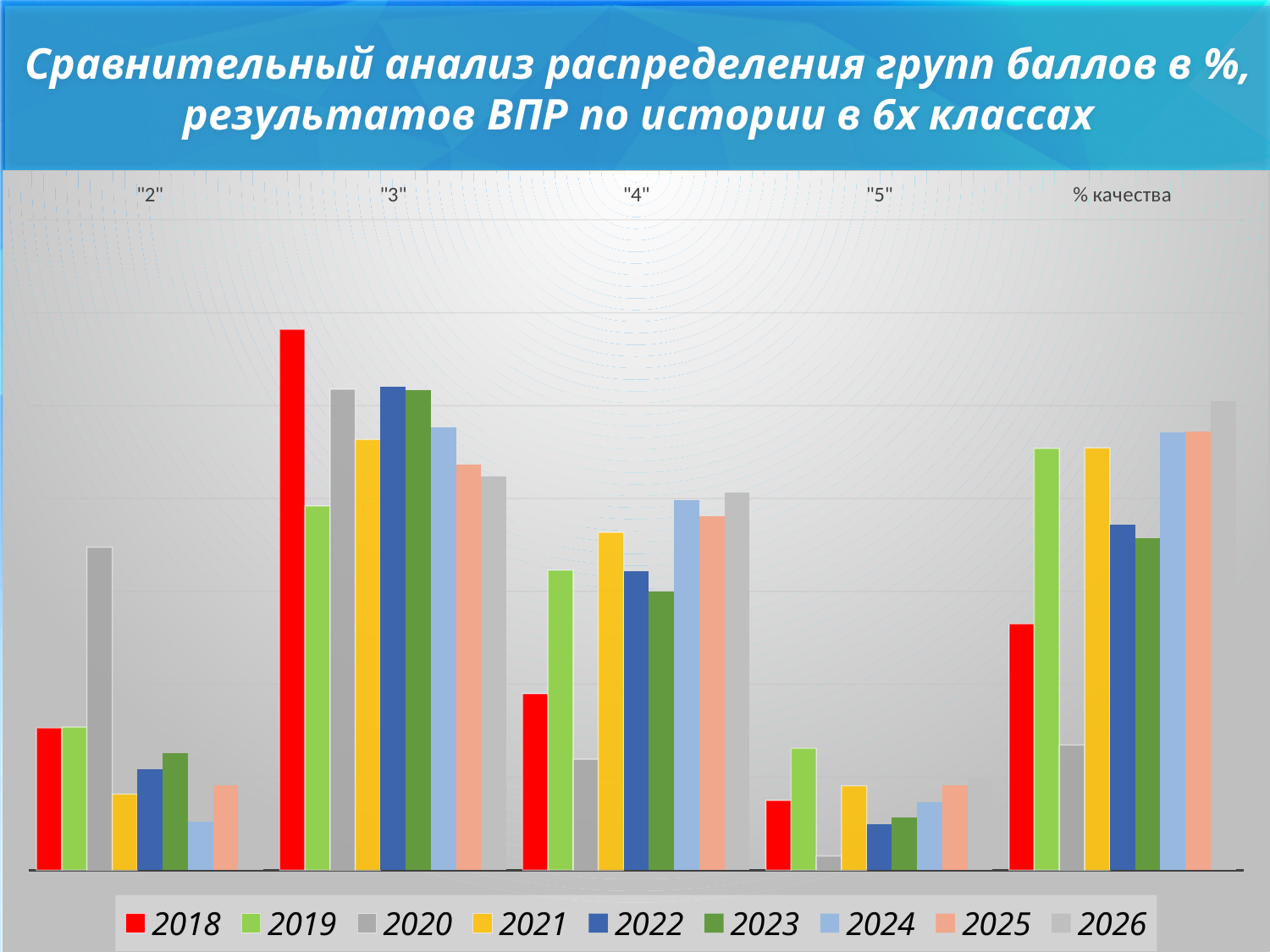
In the "3" category, which is larger, the value for 2022 or the value for 2025? 2022 In the "% качества" category, which year has the highest bar? 2026 How many categories are shown along the x axis? 5 In the "3" category, which year has the lowest bar? 2019 How many series does the legend list? 9 In the "2" category, which year has the highest bar? 2020 Which year is shown in red in the legend? 2018 In the "3" category, which year has the highest bar? 2018 In the "2" category, which year has the lowest bar? 2024 In the "4" category, which year has the lowest bar? 2020 What kind of chart is shown on the slide? bar chart